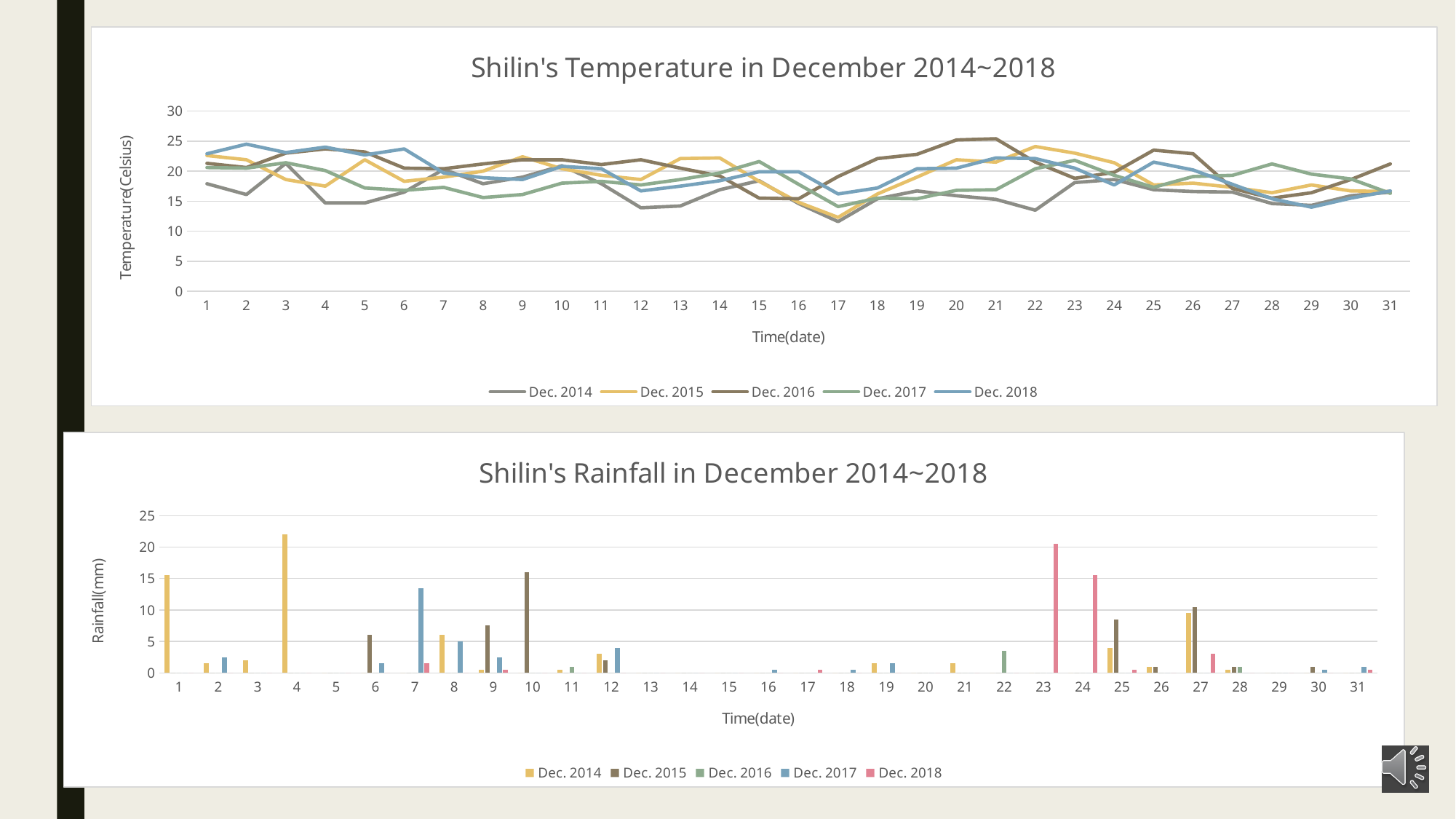
In the temperature chart, is the Dec. 2018 value on date 2 greater or less than 20? greater In the rainfall chart, which is larger: the Dec. 2014 value on date 4 or the Dec. 2015 value on date 10? Dec. 2014 value on date 4 What kind of chart is the bottom chart, 'Shilin's Rainfall in December 2014~2018'? bar chart In the temperature chart, is the Dec. 2014 value on date 12 greater or less than 15? less In the rainfall chart, is the Dec. 2017 value on date 7 greater or less than 10? greater In the rainfall chart, how many dates are shown on the x axis? 31 In the rainfall chart, which series has the taller bar on date 25, Dec. 2014 or Dec. 2015? Dec. 2015 In the rainfall chart, which series has the tallest bar on the whole chart? Dec. 2014 What is the y-axis label of the rainfall chart? Rainfall(mm) What kind of chart is the top chart, 'Shilin's Temperature in December 2014~2018'? line chart In the temperature chart, how many series does the legend list? 5